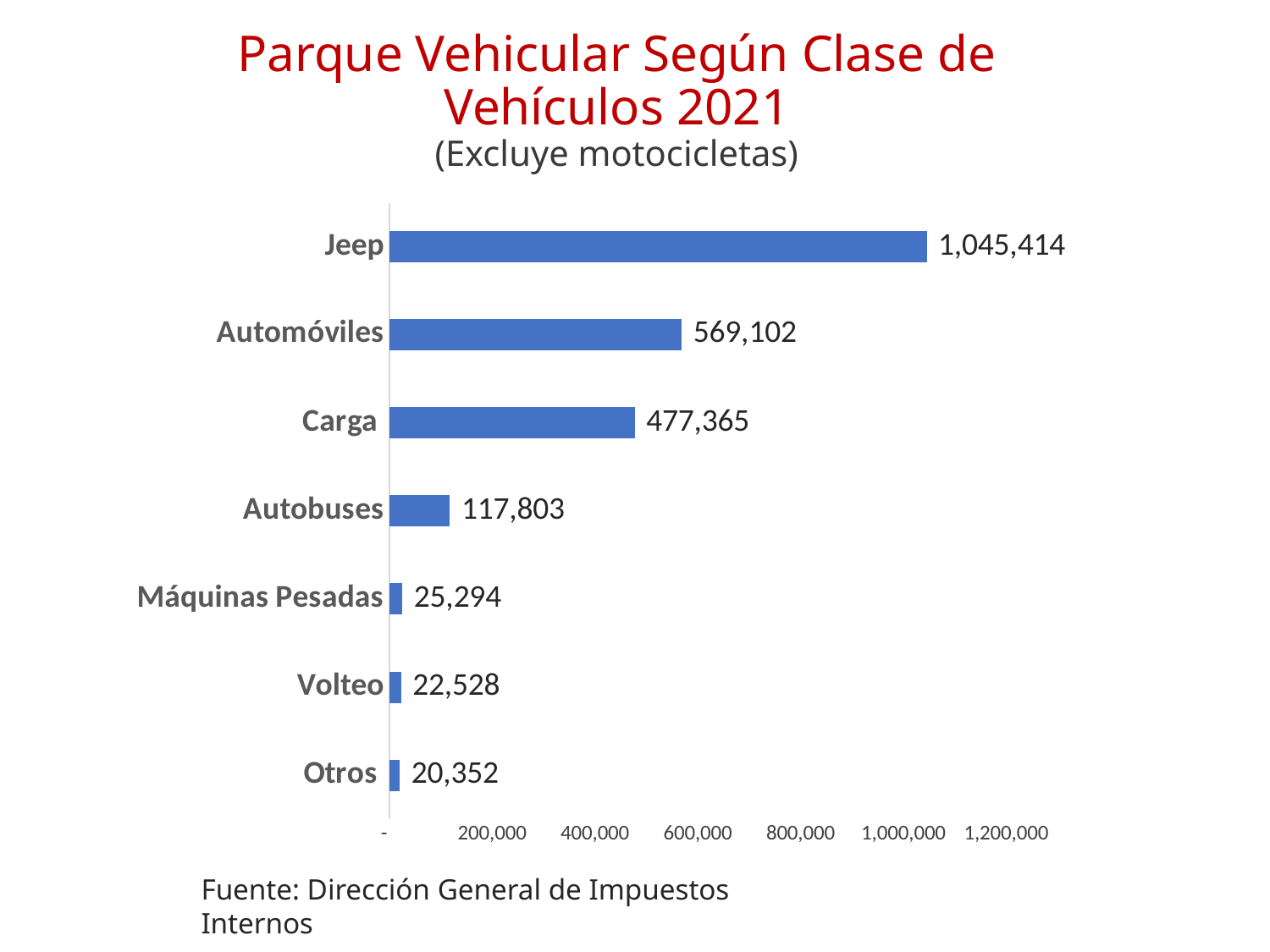
What is the value for Carga? 477,365 Which category has the lowest value? Otros What is the value for Máquinas Pesadas? 25,294 What is the difference between the values for Automóviles and Carga? 91,737 How many categories are shown in the chart? 7 What kind of chart is shown on the slide? Bar chart Is the value for Automóviles greater or less than 400,000? greater What is the value for Jeep? 1,045,414 What source is cited below the chart? Dirección General de Impuestos Internos What is the title of the chart? Parque Vehicular Según Clase de Vehículos 2021 Which category has the highest value? Jeep Which is larger, the value for Autobuses or the value for Volteo? Autobuses